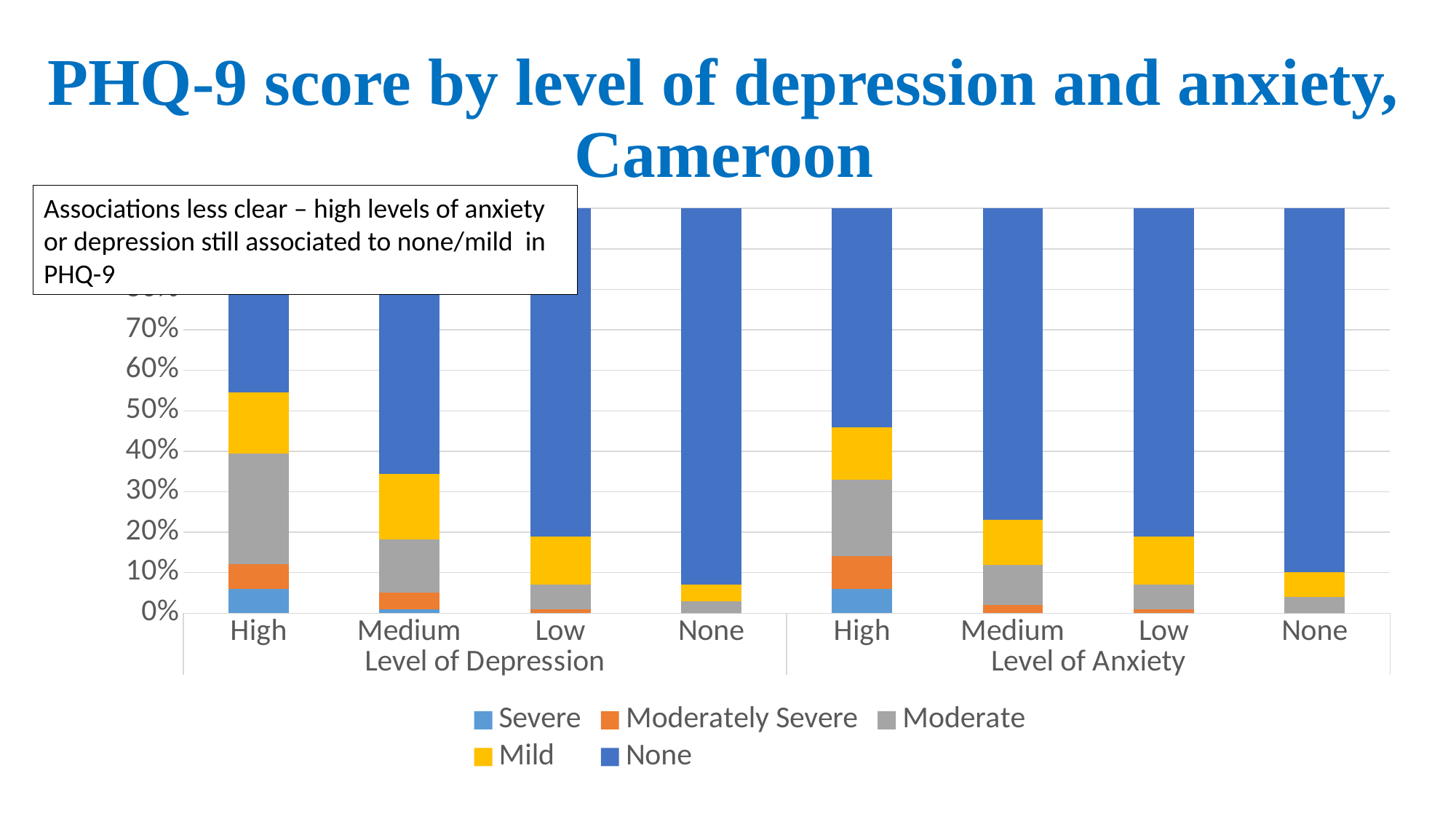
Which has the larger Moderate (grey) segment: High or Medium under Level of Depression? High Is the share of the None (blue) segment for the High category under Level of Depression greater or less than 50%? less Is the share of the None (blue) segment for the Medium category under Level of Anxiety greater or less than 70%? greater What is the title of the slide's chart? PHQ-9 score by level of depression and anxiety, Cameroon Is the share of the None (blue) segment for the High category under Level of Anxiety greater or less than 50%? greater Among the Level of Anxiety categories, which has the smallest None (blue) segment? High How many series does the legend list? 5 Among the Level of Depression categories, which has the largest None (blue) segment? None What kind of chart is shown on the slide? Stacked bar chart Which legend entry is shown in yellow? Mild How many bars are plotted in the chart? 8